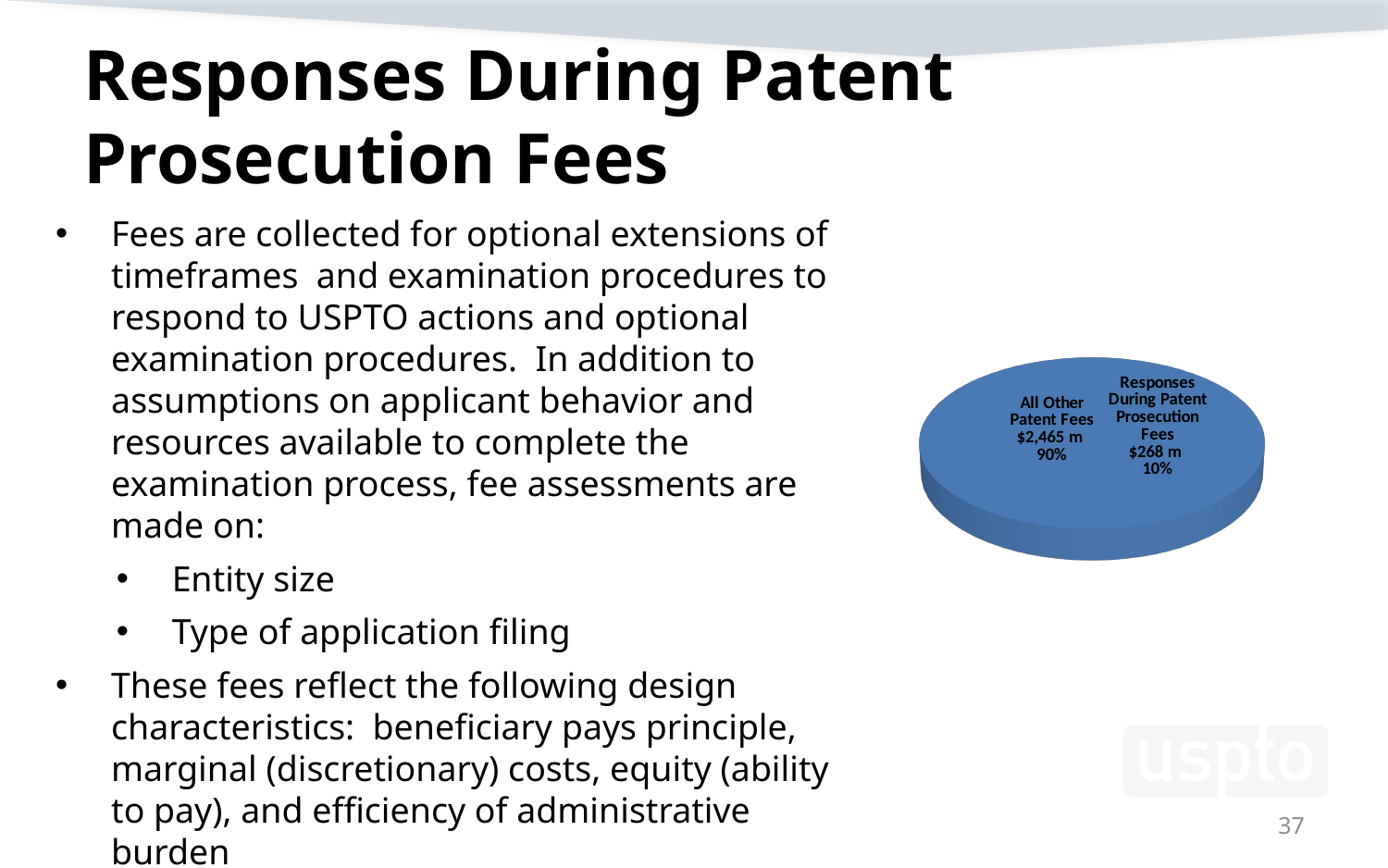
What share of the pie does Responses During Patent Prosecution Fees represent? 10% Which slice of the pie chart is the smallest? Responses During Patent Prosecution Fees What share of the pie does All Other Patent Fees represent? 90% What is the difference in dollar value between All Other Patent Fees and Responses During Patent Prosecution Fees? $2,197 m What kind of chart is shown on the slide? pie chart Which slice of the pie chart is the largest? All Other Patent Fees What is the value shown for All Other Patent Fees in the pie chart? $2,465 m Which is larger: All Other Patent Fees or Responses During Patent Prosecution Fees? All Other Patent Fees What is the value shown for Responses During Patent Prosecution Fees in the pie chart? $268 m What is the combined dollar value of the two slices in the pie chart? $2,733 m What is the title of the slide containing the pie chart? Responses During Patent Prosecution Fees How many slices does the pie chart have? 2